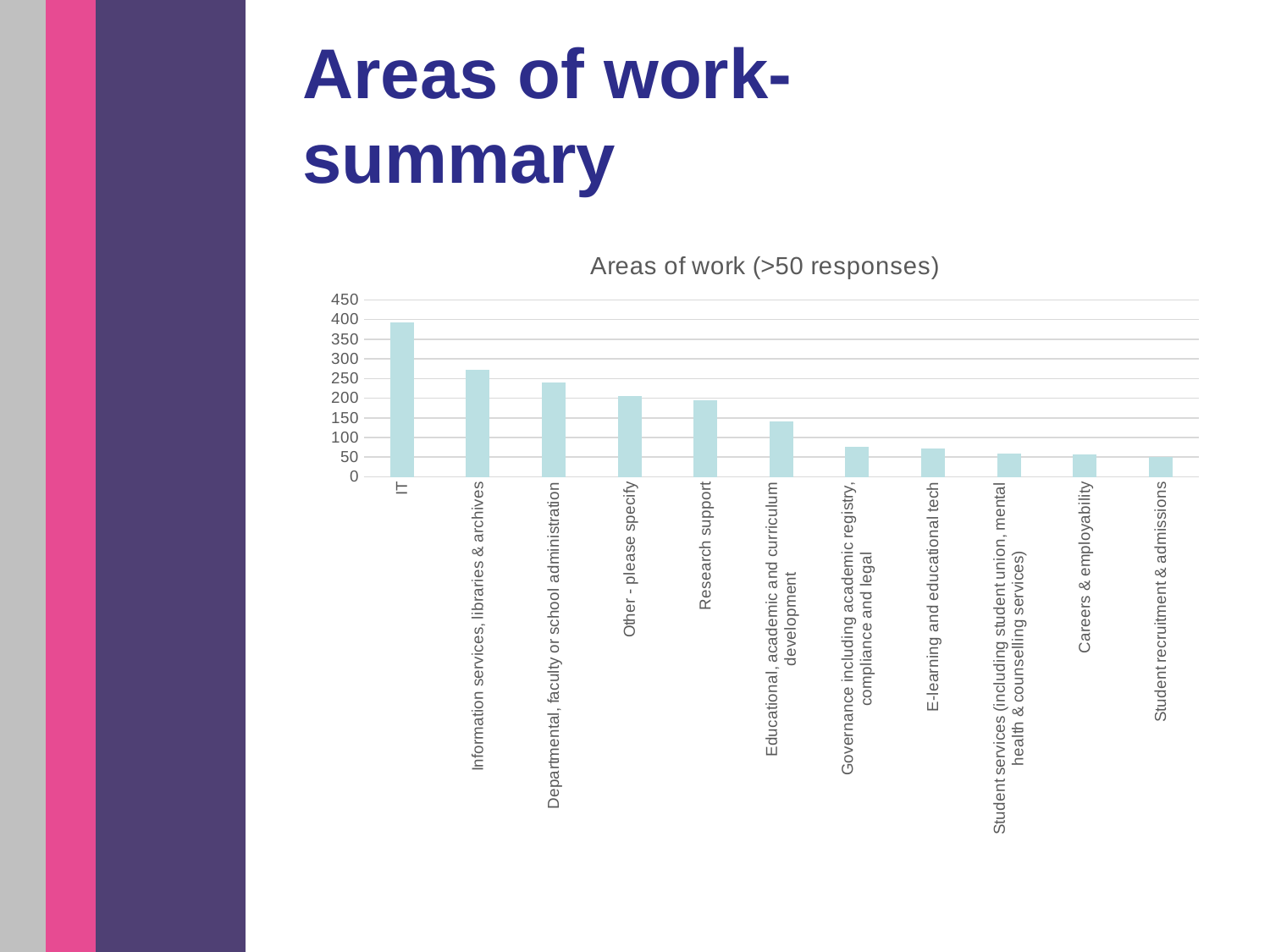
How many areas of work are plotted in the chart? 11 What is the title of the chart? Areas of work (>50 responses) Is the value for Governance including academic registry, compliance and legal greater or less than 100? less Is the value for Departmental, faculty or school administration greater or less than 300? less What kind of chart is shown on the slide? bar chart Do the values rise or fall moving from left to right along the x axis? fall Which has more responses: Educational, academic and curriculum development or E-learning and educational tech? Educational, academic and curriculum development Which area of work has the highest number of responses? IT Is the value for Information services, libraries & archives greater or less than 250? greater Which has more responses: IT or Information services, libraries & archives? IT